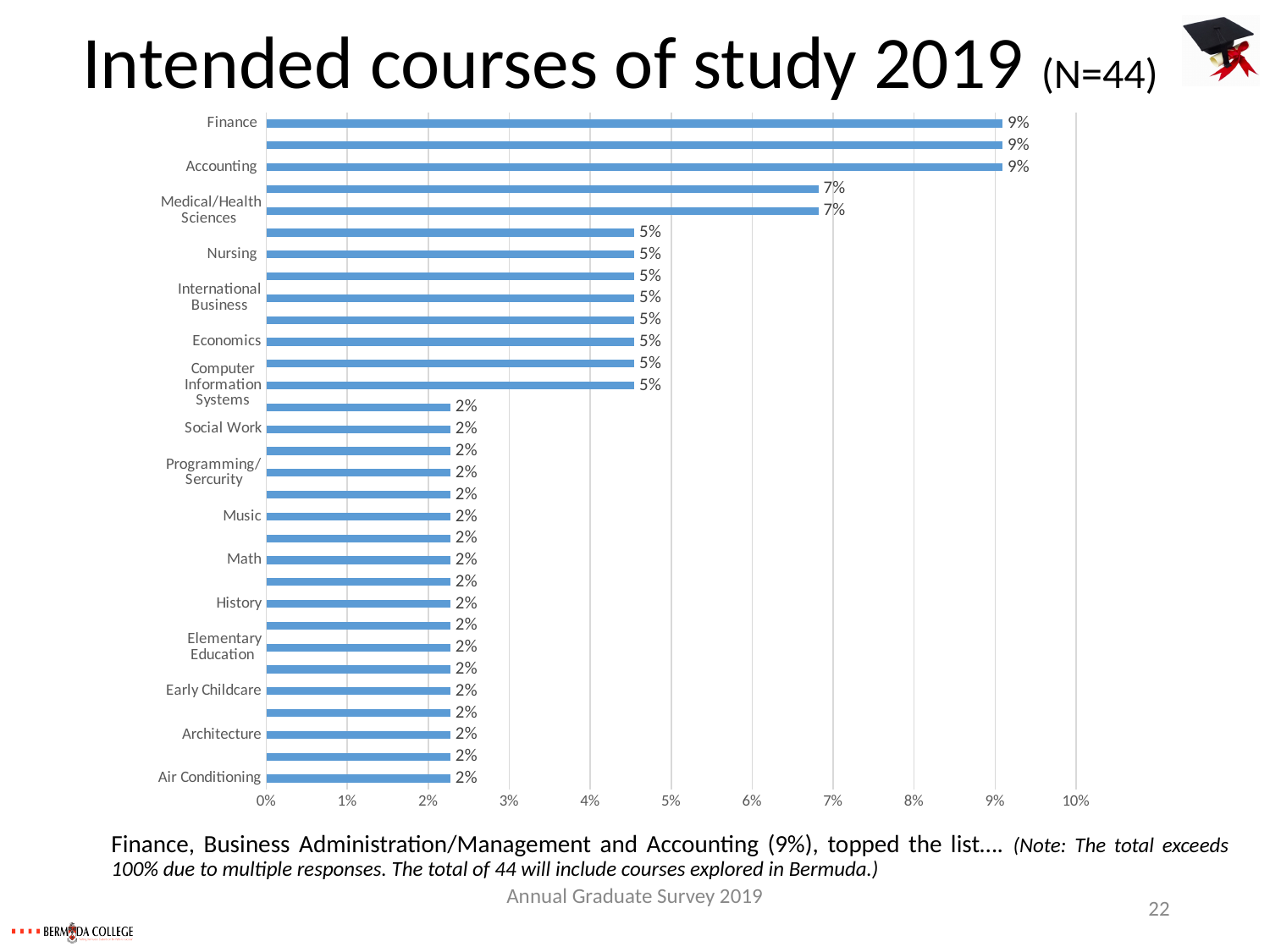
What is the difference between the values for Finance and Medical/Health Sciences? 2 percentage points Is the value for Accounting greater or less than 8%? greater Which is larger, the value for Economics or the value for Math? Economics What is the highest value shown on the chart? 9% What is the value for Medical/Health Sciences? 7% What is the value for Computer Information Systems? 5% What is the title of the chart on the slide? Intended courses of study 2019 (N=44) What is the value for Social Work? 2% What is the value for Finance? 9% What is the value for Nursing? 5% What is the lowest value shown on the chart? 2% What kind of chart is shown on the slide? bar chart